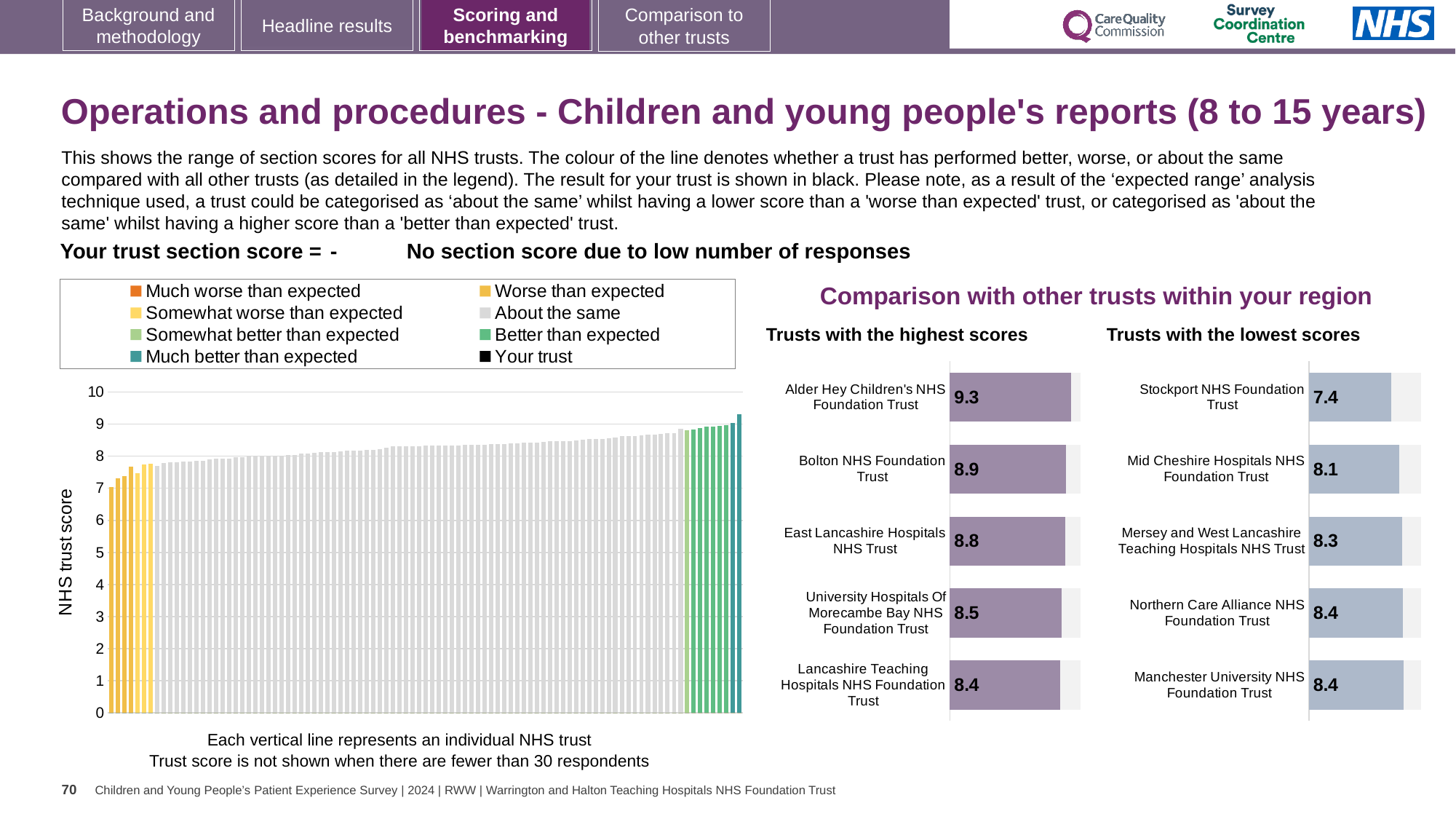
How many trusts are listed in the 'Trusts with the highest scores' chart? 5 In the large chart on the left, do the trust scores rise or fall from left to right? Rise What kind of chart is the large chart on the left showing NHS trust scores? Bar chart In the 'Trusts with the highest scores' chart, what is the difference between the scores of Alder Hey Children's NHS Foundation Trust and Bolton NHS Foundation Trust? 0.4 In the 'Trusts with the highest scores' chart, which trust has the highest score? Alder Hey Children's NHS Foundation Trust In the 'Trusts with the lowest scores' chart, which has the larger score: Mid Cheshire Hospitals NHS Foundation Trust or Mersey and West Lancashire Teaching Hospitals NHS Trust? Mersey and West Lancashire Teaching Hospitals NHS Trust In the 'Trusts with the highest scores' chart, what is the score for Alder Hey Children's NHS Foundation Trust? 9.3 In the 'Trusts with the lowest scores' chart, which trust has the lowest score? Stockport NHS Foundation Trust In the 'Trusts with the lowest scores' chart, what is the score for Stockport NHS Foundation Trust? 7.4 How many entries does the legend above the large chart on the left list? 8 In the large chart on the left, is the value of the leftmost bar greater or less than 5? greater What is the label on the vertical axis of the large chart on the left? NHS trust score